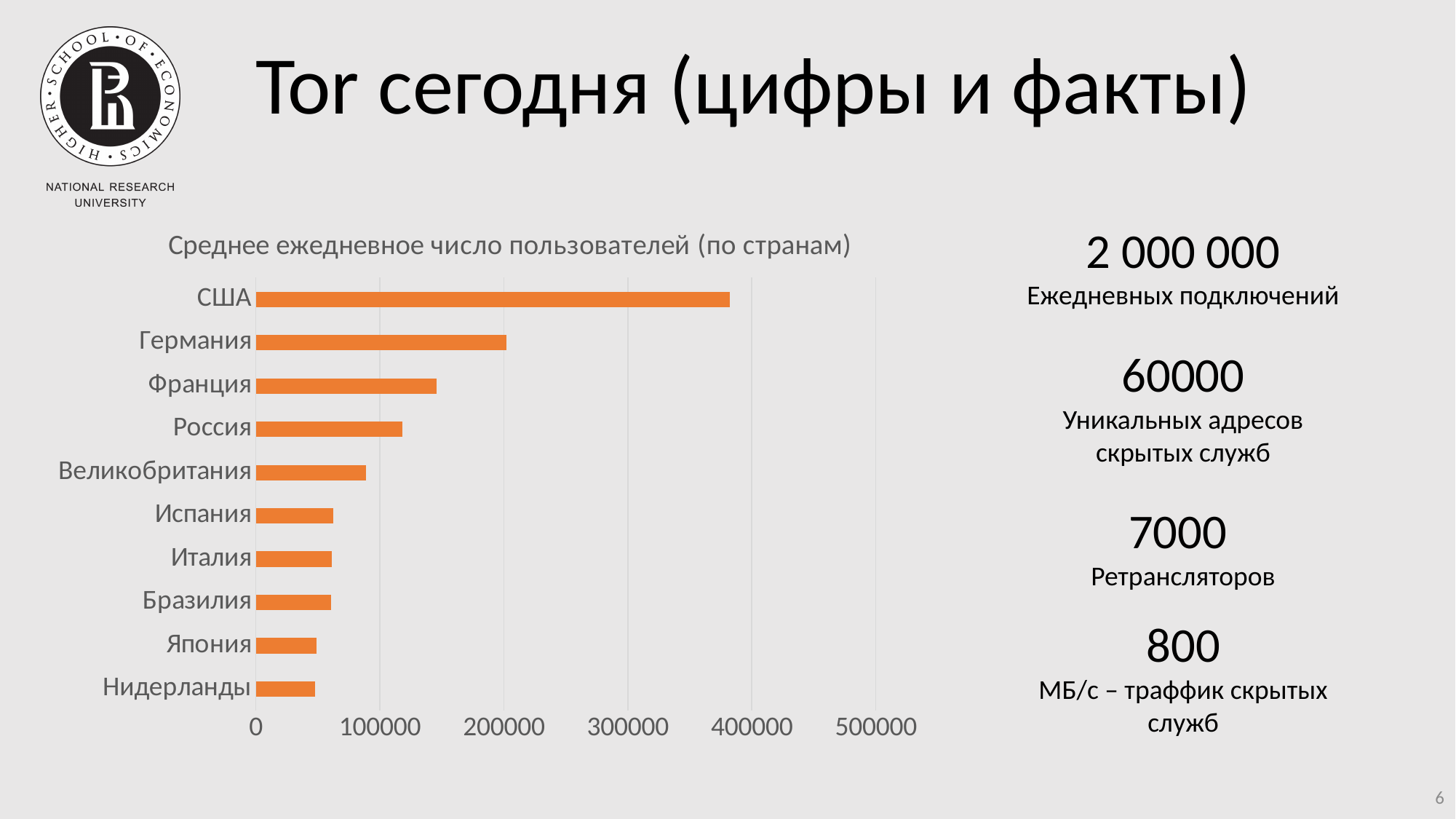
What is the title of the chart? Среднее ежедневное число пользователей (по странам) Which country has the highest average daily number of users? США Is the value for Япония greater or less than 100000? less Is the value for Россия greater or less than 100000? greater Is the value for США greater or less than 300000? greater Which has a larger value, Россия or Великобритания? Россия What colour are the bars in the chart? orange What kind of chart is shown on the slide? bar chart How many countries are shown in the chart? 10 Which has a larger value, Германия or Франция? Германия